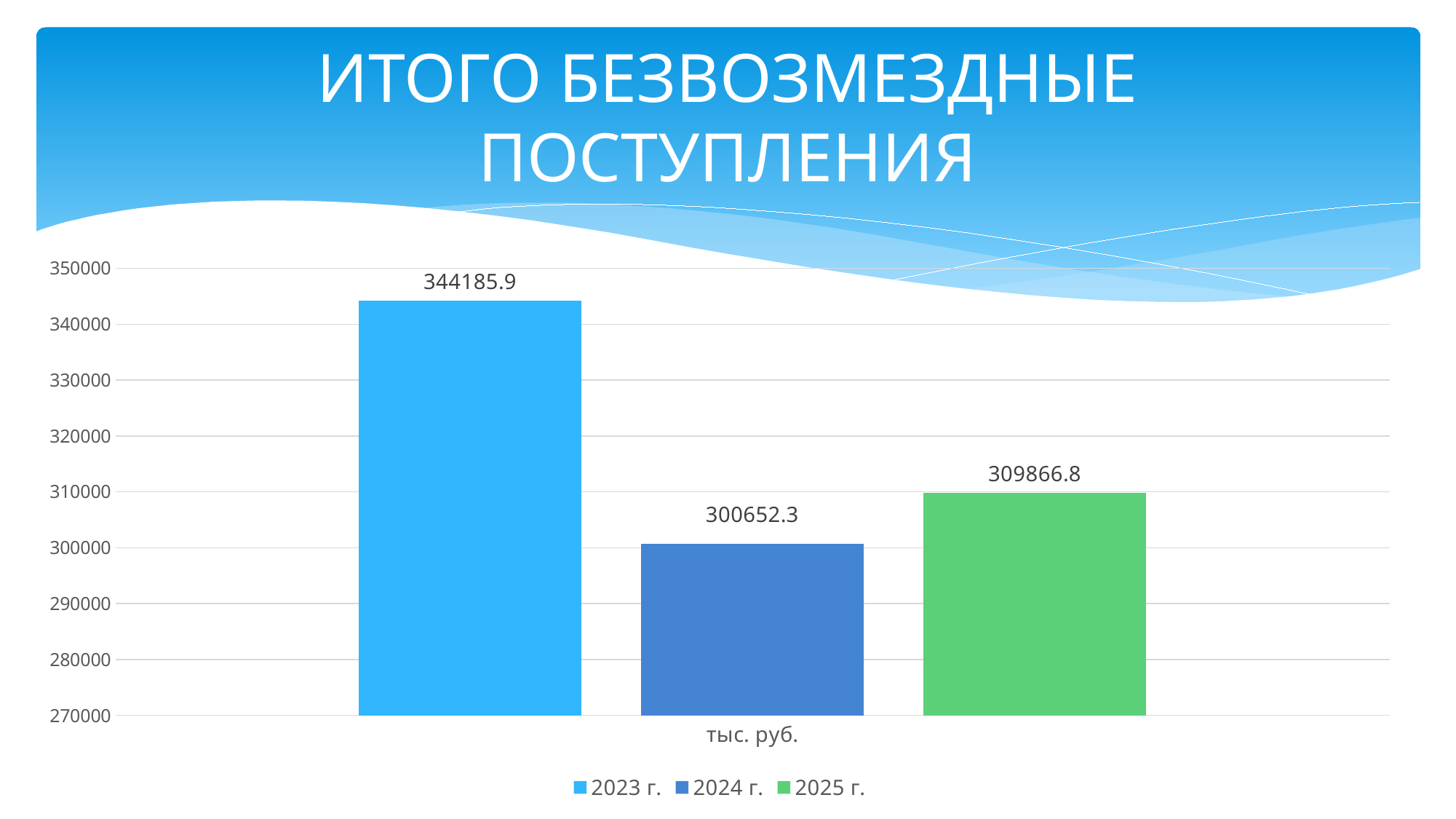
Which year has the highest value? 2023 г. What is the difference between the values for 2025 г. and 2024 г.? 9214.5 Is the value for 2023 г. greater or less than 340000? greater What is the value for 2023 г.? 344185.9 Which year has the lowest value? 2024 г. How many series does the legend list? 3 What is the value for 2024 г.? 300652.3 What is the value for 2025 г.? 309866.8 What is the difference between the values for 2023 г. and 2024 г.? 43533.6 What kind of chart is shown on the slide? bar chart Which is larger, the value for 2025 г. or the value for 2024 г.? 2025 г. What is the title of the slide? ИТОГО БЕЗВОЗМЕЗДНЫЕ ПОСТУПЛЕНИЯ